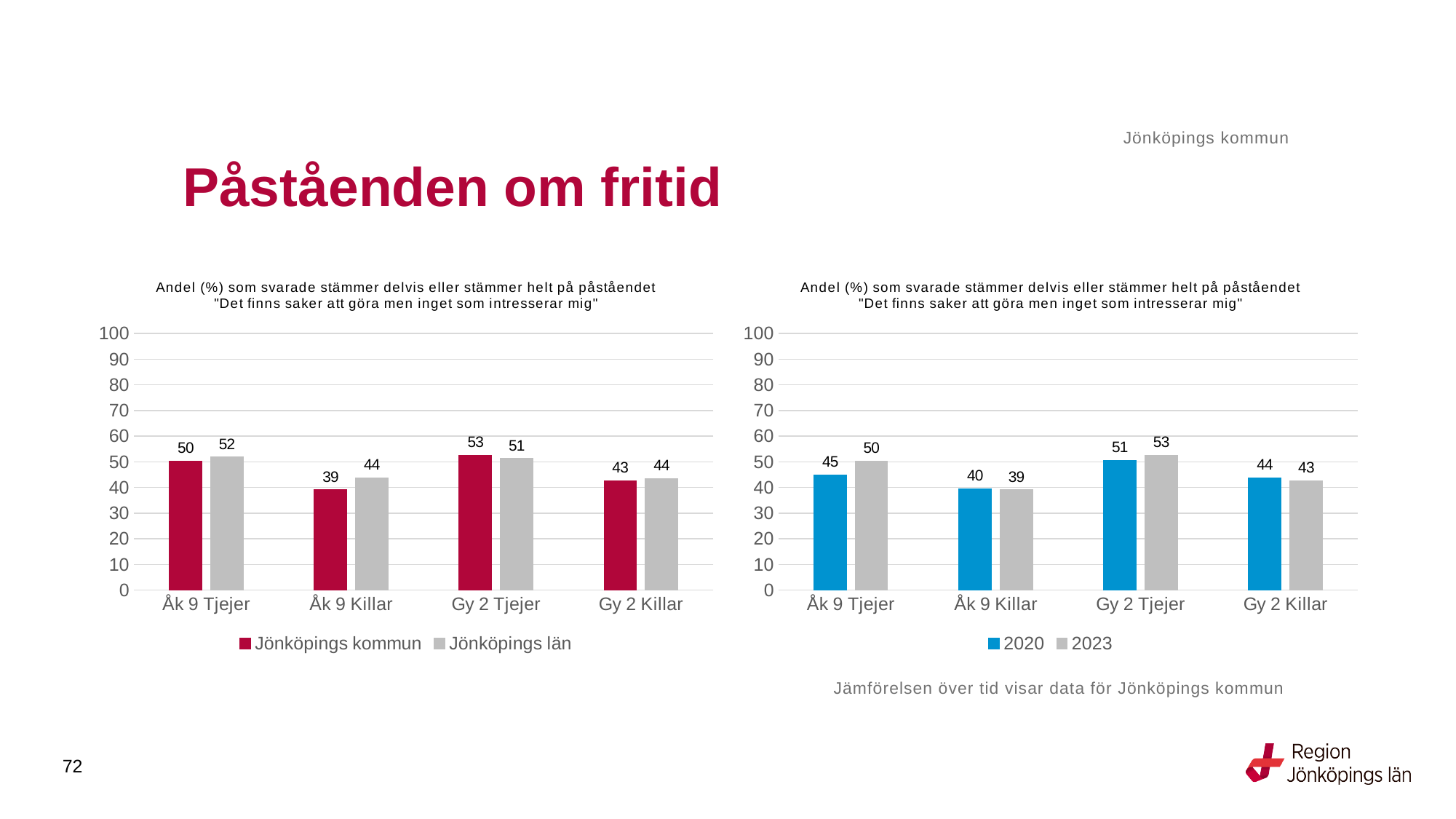
In the left chart, what is the value for Jönköpings län for Gy 2 Tjejer? 51 What type of chart is the left chart? Bar chart In the right chart, which is larger for Gy 2 Tjejer: the 2020 value or the 2023 value? 2023 In the right chart, what is the value for 2020 for Gy 2 Killar? 44 In the left chart, which category has the highest value for Jönköpings kommun? Gy 2 Tjejer In the right chart, is the 2020 value for Åk 9 Killar greater or less than 50? less In the right chart, what is the value for 2023 for Åk 9 Tjejer? 50 In the left chart, what is the value for Jönköpings kommun for Åk 9 Killar? 39 In the right chart, which category has the lowest value for 2023? Åk 9 Killar In the left chart, what is the difference between the Jönköpings län and Jönköpings kommun values for Åk 9 Killar? 5 How many series does the legend of the right chart list? 2 How many categories are shown on the x axis of the left chart? 4